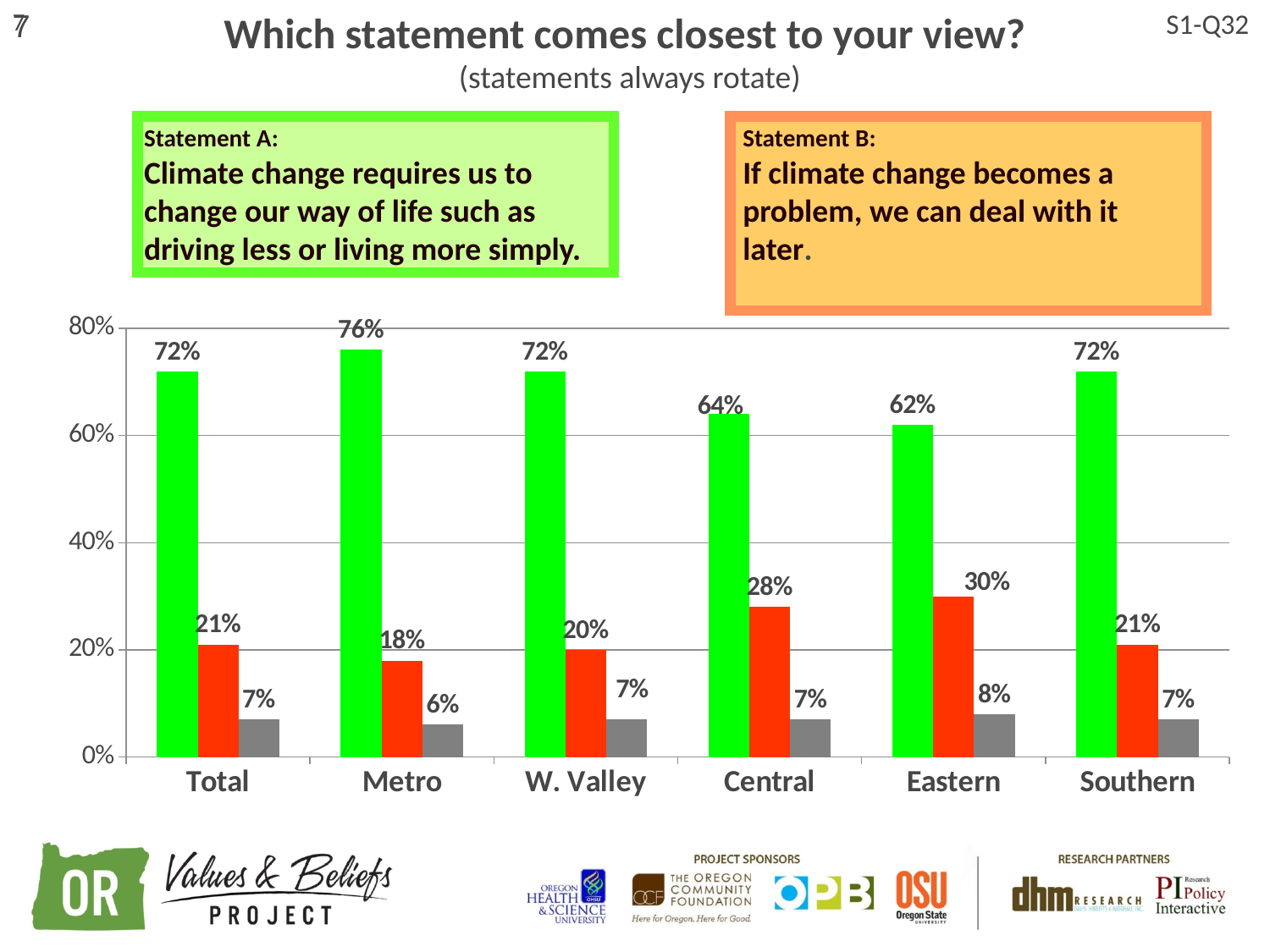
What type of chart is shown on the slide? bar chart What is the value of the gray bar for Metro? 6% Which category has the lowest green bar? Eastern What is the difference between the green bar and the orange bar for Central? 36% How many categories are shown on the x axis? 6 What is the value of the orange bar for Central? 28% Which category has the highest green bar? Metro What is the value of the orange bar for Eastern? 30% Which category has the highest orange bar? Eastern Is the orange bar for Eastern larger or smaller than the orange bar for Metro? larger What is the value of the green bar for Metro? 76% What colour are the bars representing Statement A? green